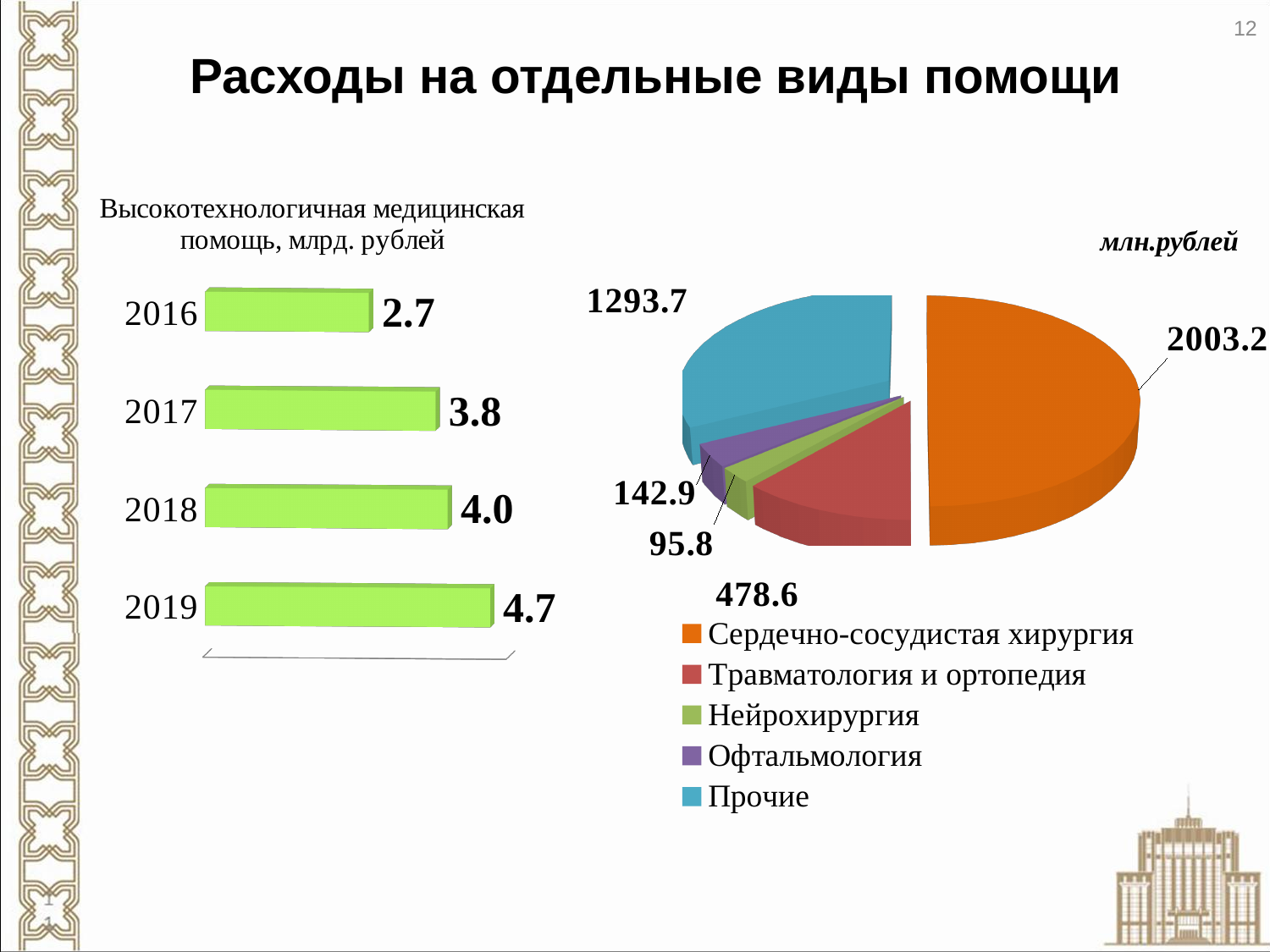
In the pie chart on the right, which category has the largest value? Сердечно-сосудистая хирургия In the bar chart on the left, what is the value for 2019? 4.7 In the bar chart on the left, which year has the lowest value? 2016 In the bar chart on the left, what is the value for 2017? 3.8 In the pie chart on the right, what is the value for Травматология и ортопедия? 478.6 In the bar chart on the left, what is the difference between the values for 2019 and 2016? 2.0 In the bar chart on the left, do the values rise or fall from 2016 to 2019? rise In the pie chart on the right, how many categories does the legend list? 5 In the pie chart on the right, which category has the smallest value? Нейрохирургия In the bar chart on the left, how many years are shown? 4 What kind of chart is the chart on the left of the slide? bar chart In the pie chart on the right, which is larger: Офтальмология or Нейрохирургия? Офтальмология